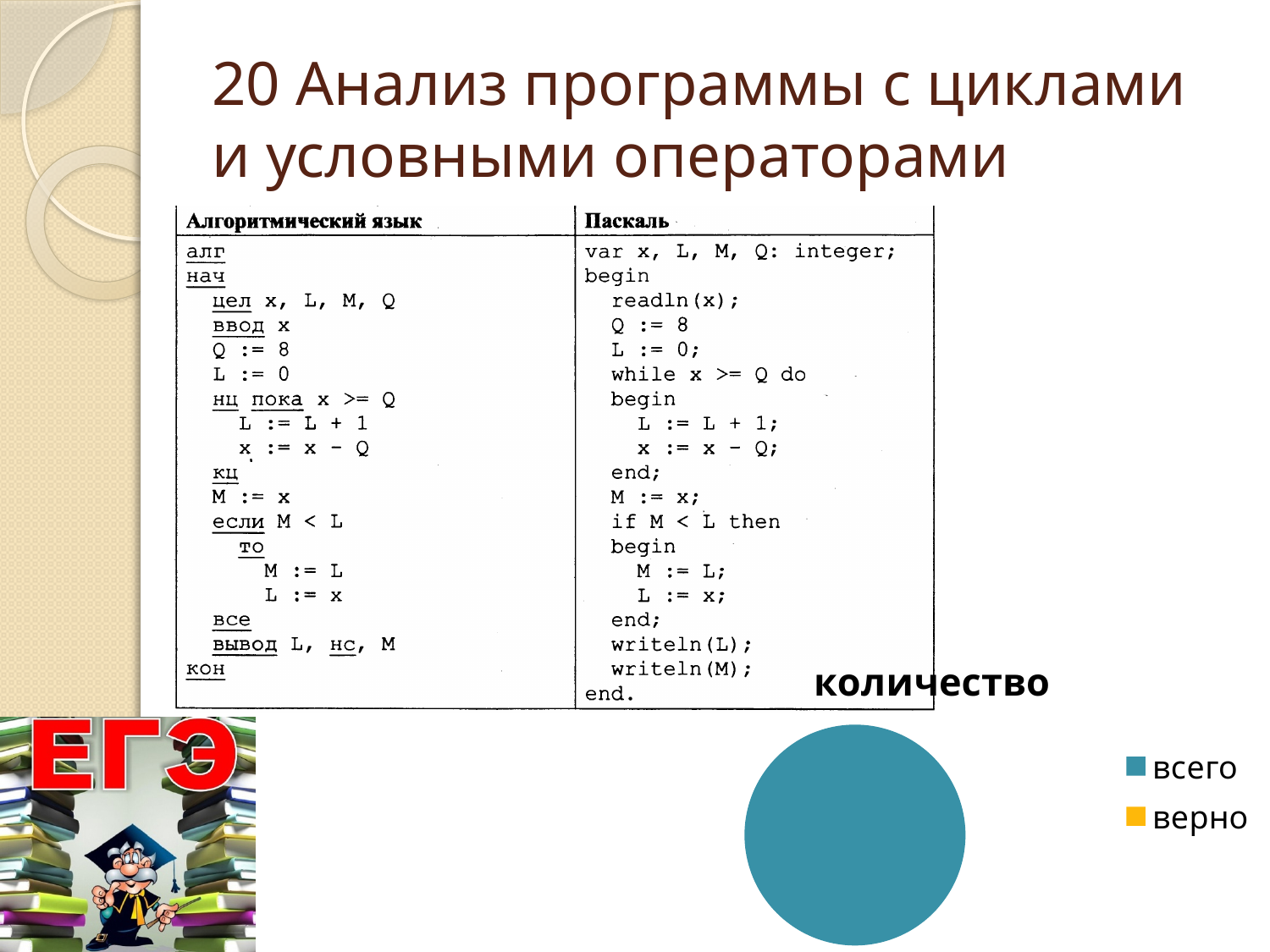
How many series does the chart's legend list? 2 What kind of chart is shown on the slide? pie chart Which is larger in the pie chart, всего or верно? всего Which category occupies the smallest share of the pie chart? верно What colour represents всего in the chart's legend? teal (blue) What is the title of the chart on the slide? количество Which category occupies the largest share of the pie chart? всего